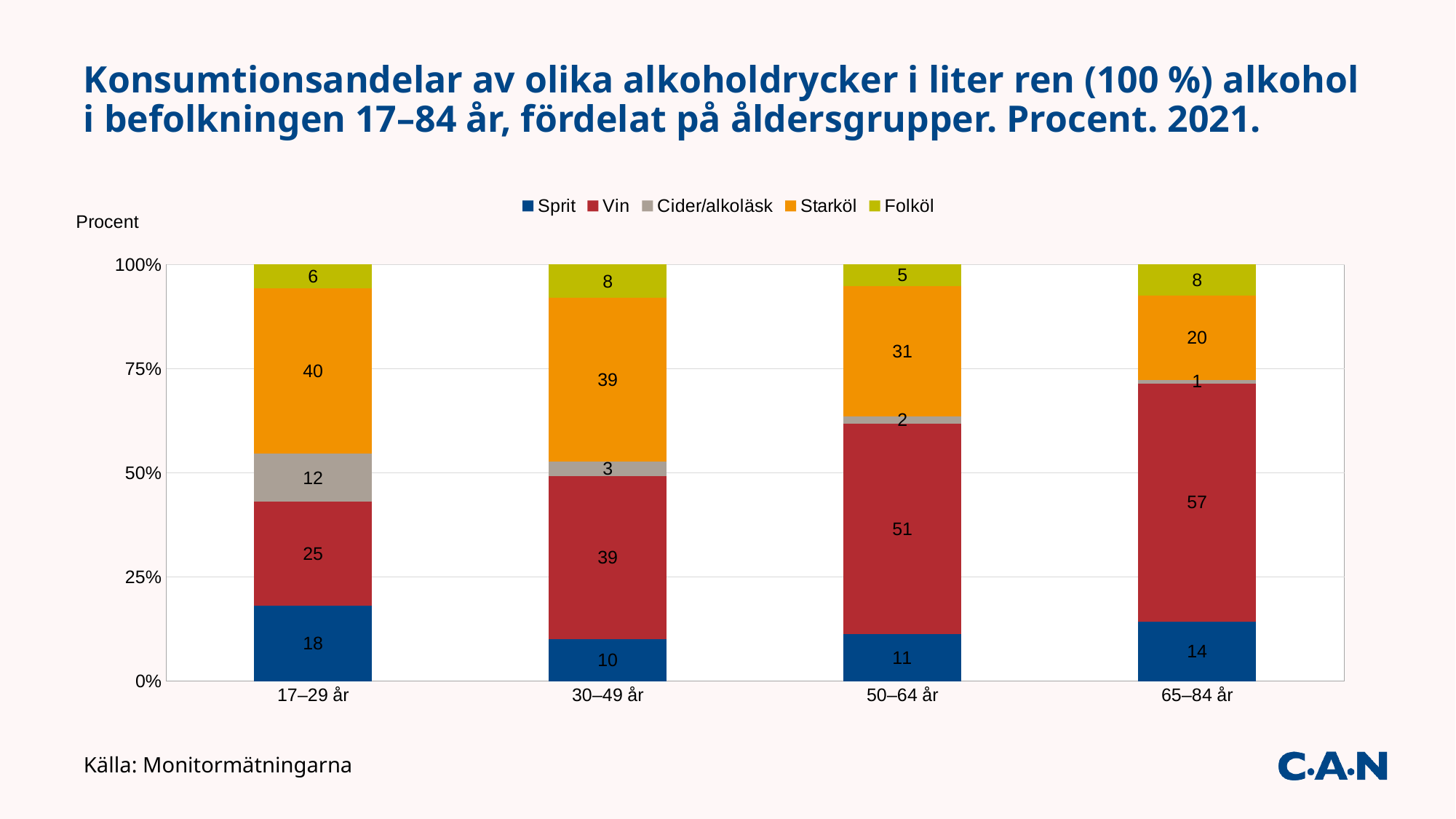
What is the value for Vin in the 65–84 år age group? 57 What is the difference between the Starköl value for 17–29 år and for 65–84 år? 20 What is the value for Starköl in the 17–29 år age group? 40 What kind of chart is shown on the slide? Stacked bar chart Which age group has the larger Sprit value, 17–29 år or 65–84 år? 17–29 år Does the value for Vin rise or fall as the age groups go from 17–29 år to 65–84 år? Rises What colour represents Starköl in the chart? Orange Which age group has the highest value for Vin? 65–84 år How many age groups are shown on the x axis? 4 Which age group has the lowest value for Sprit? 30–49 år What is the value for Cider/alkoläsk in the 30–49 år age group? 3 How many series does the legend list? 5